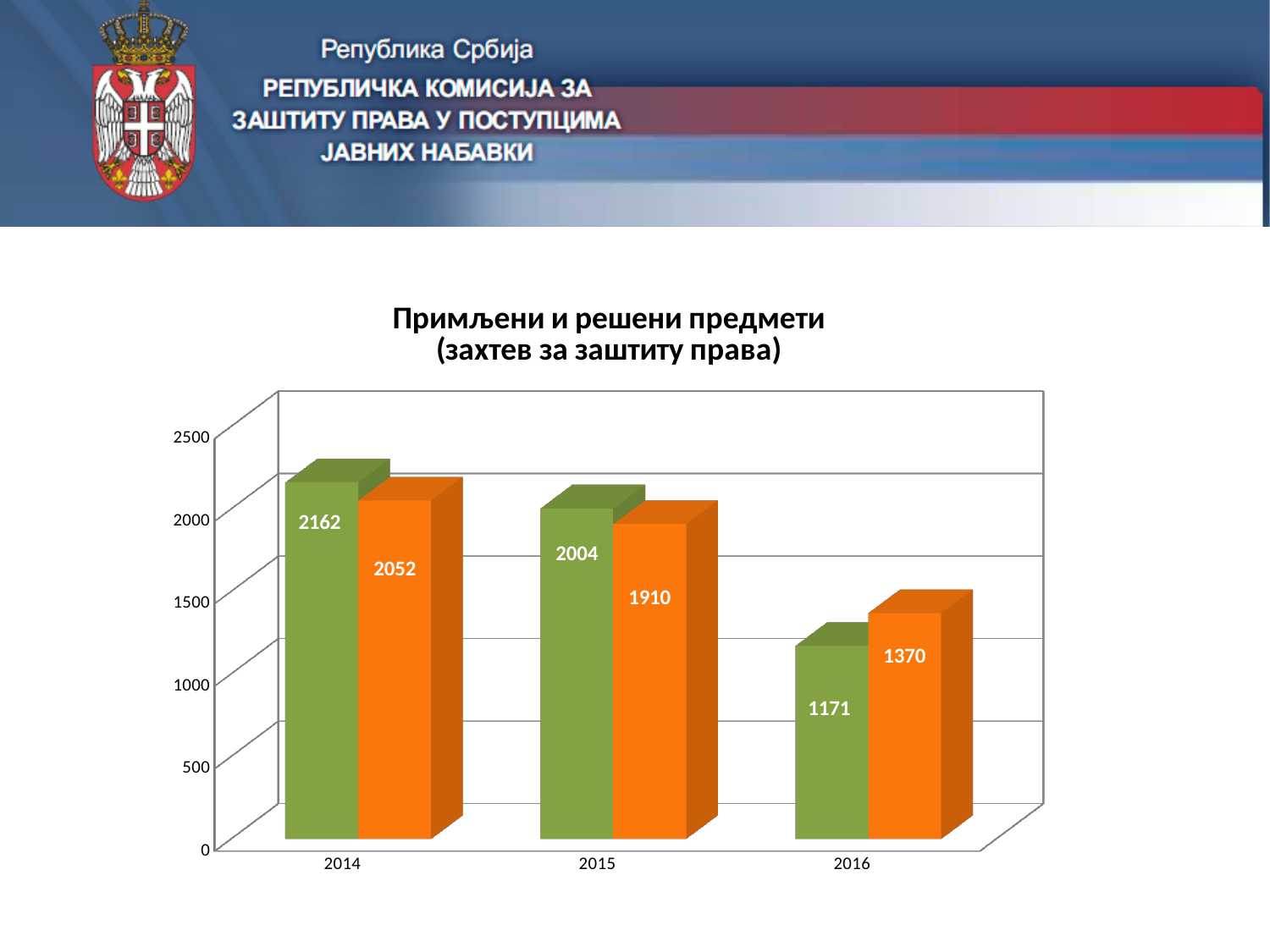
In which year is the green bar the highest? 2014 In which year is the orange bar the lowest? 2016 In 2016, which bar is larger, the green or the orange? orange What is the value of the orange bar for 2016? 1370 How many years are shown on the x axis? 3 What is the value of the orange bar for 2015? 1910 What is the difference between the green and orange bars in 2014? 110 What is the difference between the green bar values for 2015 and 2016? 833 What is the value of the green bar for 2014? 2162 Do the green bar values rise or fall from 2014 to 2016? fall What kind of chart is shown on the slide? bar chart Is the value of the green bar for 2015 greater or less than 1500? greater